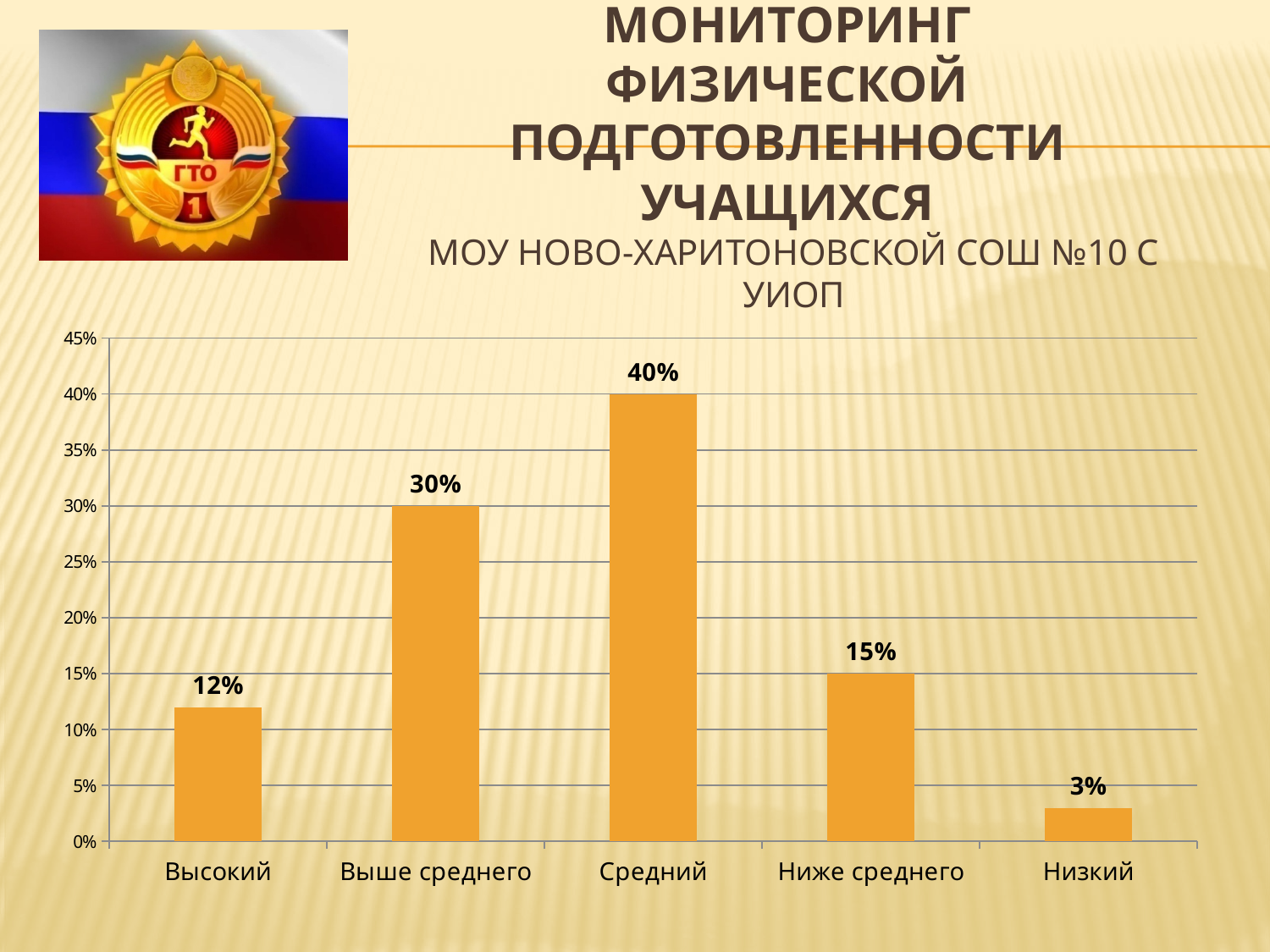
Which is larger, the value for Высокий or the value for Ниже среднего? Ниже среднего What is the highest value shown on the vertical axis? 45% How many categories are shown on the x axis? 5 What is the value for Выше среднего? 30% What is the value for Средний? 40% What is the value for Низкий? 3% Which category has the lowest value? Низкий What is the difference between the values for Средний and Выше среднего? 10% What is the value for Высокий? 12% What is the value for Ниже среднего? 15% Which category has the highest value? Средний What kind of chart is shown on the slide? Bar chart